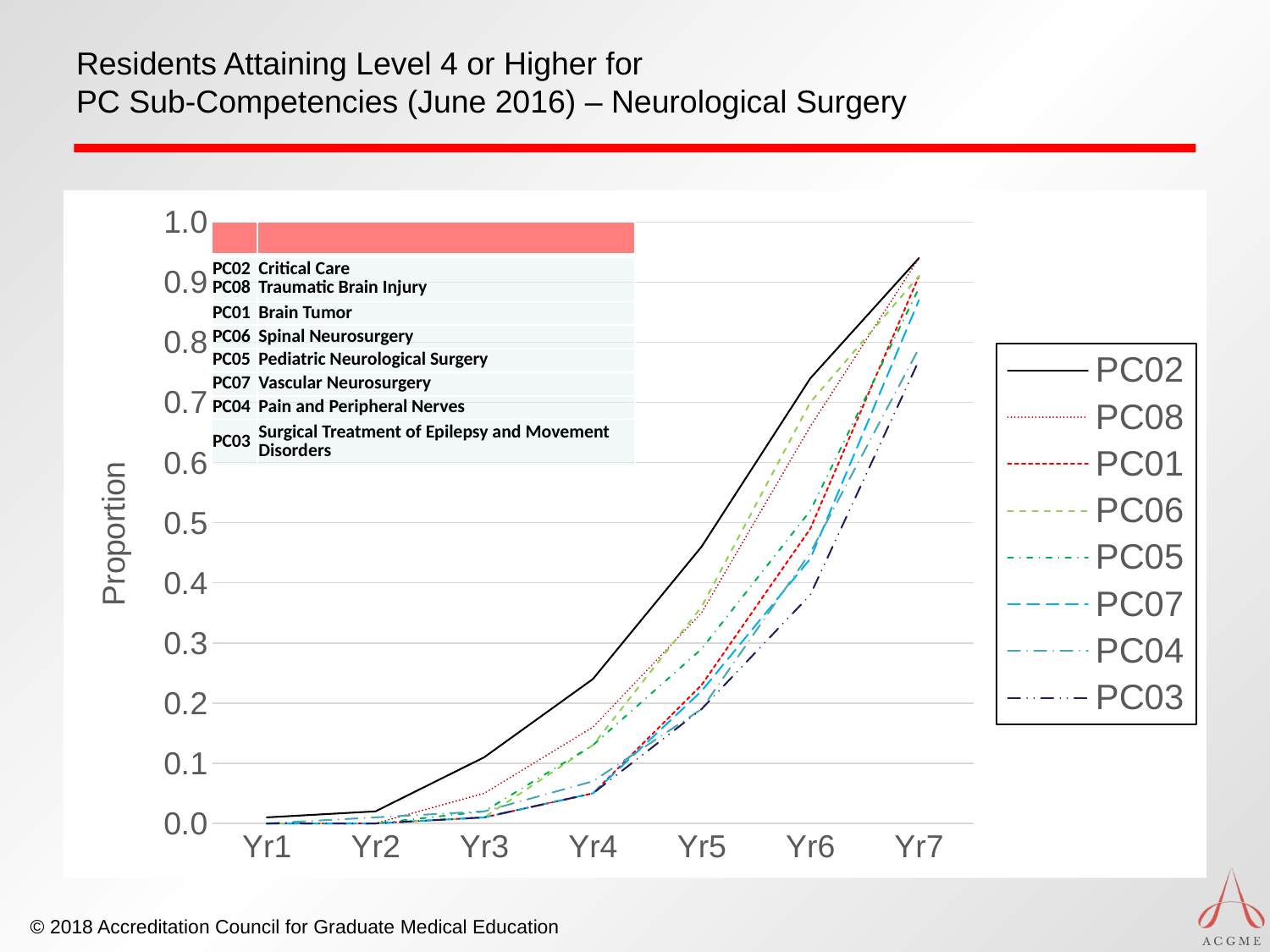
At Yr6, which is larger, the value for PC02 or the value for PC03? PC02 Does the PC02 line rise or fall from Yr1 to Yr7? rise Is the value for PC02 at Yr7 greater or less than 0.9? greater Which series has the highest value at Yr5? PC02 Is the value for PC03 at Yr5 greater or less than 0.3? less How many year categories are shown on the x axis? 7 What is the label on the y axis? Proportion Which series has the highest value at Yr7? PC02 Is the value for PC02 at Yr5 greater or less than 0.4? greater What kind of chart is shown on the slide? line chart How many series does the legend list? 8 Which series has the lowest value at Yr6? PC03